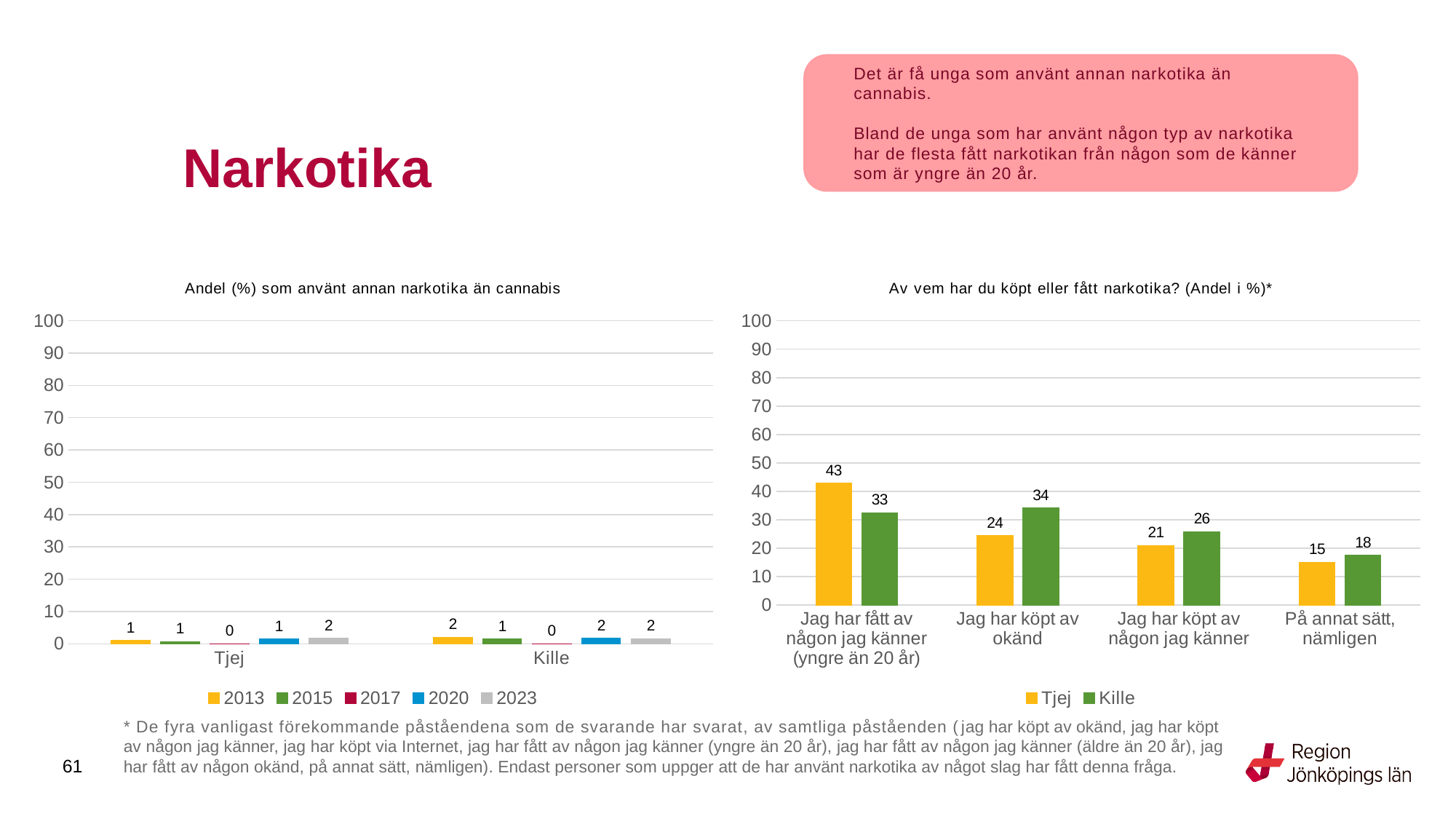
In the chart 'Av vem har du köpt eller fått narkotika? (Andel i %)*', what is the value for Kille in the category 'Jag har köpt av okänd'? 34 In the chart 'Av vem har du köpt eller fått narkotika? (Andel i %)*', what is the difference between Tjej and Kille in the category 'Jag har fått av någon jag känner (yngre än 20 år)'? 10 In the chart 'Av vem har du köpt eller fått narkotika? (Andel i %)*', which category has the lowest value for Kille? På annat sätt, nämligen What kind of chart is 'Andel (%) som använt annan narkotika än cannabis'? Bar chart In the chart 'Andel (%) som använt annan narkotika än cannabis', what is the value for 2017 for Tjej? 0 In the chart 'Andel (%) som använt annan narkotika än cannabis', how many series does the legend list? 5 In the chart 'Av vem har du köpt eller fått narkotika? (Andel i %)*', what is the value for Tjej in the category 'Jag har fått av någon jag känner (yngre än 20 år)'? 43 In the chart 'Av vem har du köpt eller fått narkotika? (Andel i %)*', what colour are the bars for Kille? Green In the chart 'Av vem har du köpt eller fått narkotika? (Andel i %)*', which is larger in the category 'Jag har köpt av någon jag känner': Tjej or Kille? Kille In the chart 'Av vem har du köpt eller fått narkotika? (Andel i %)*', which category has the highest value for Tjej? Jag har fått av någon jag känner (yngre än 20 år) In the chart 'Av vem har du köpt eller fått narkotika? (Andel i %)*', how many categories are shown on the x axis? 4 In the chart 'Andel (%) som använt annan narkotika än cannabis', what is the value for 2023 for Kille? 2